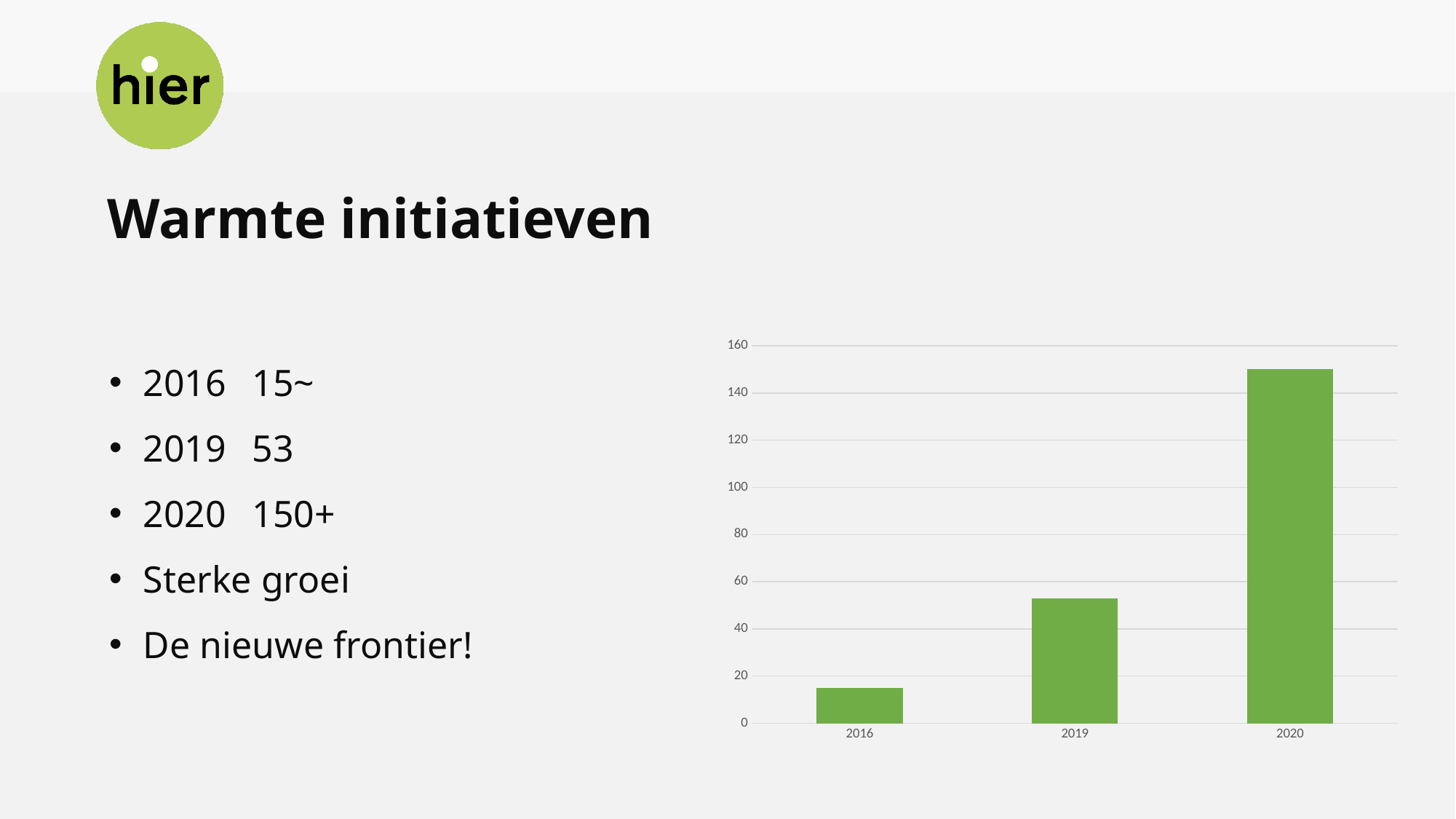
Is the value for 2019 greater or less than 40? greater Is the value for 2020 greater or less than 140? greater Is the value for 2019 greater or less than 60? less Which year has the lowest bar in the chart? 2016 How many bars (categories) does the chart show? 3 What colour are the bars in the chart? green Do the values rise or fall from 2016 to 2020 along the x axis? rise Which year has the highest bar in the chart? 2020 Which is larger, the value for 2019 or the value for 2016? 2019 What kind of chart is shown on the slide? bar chart